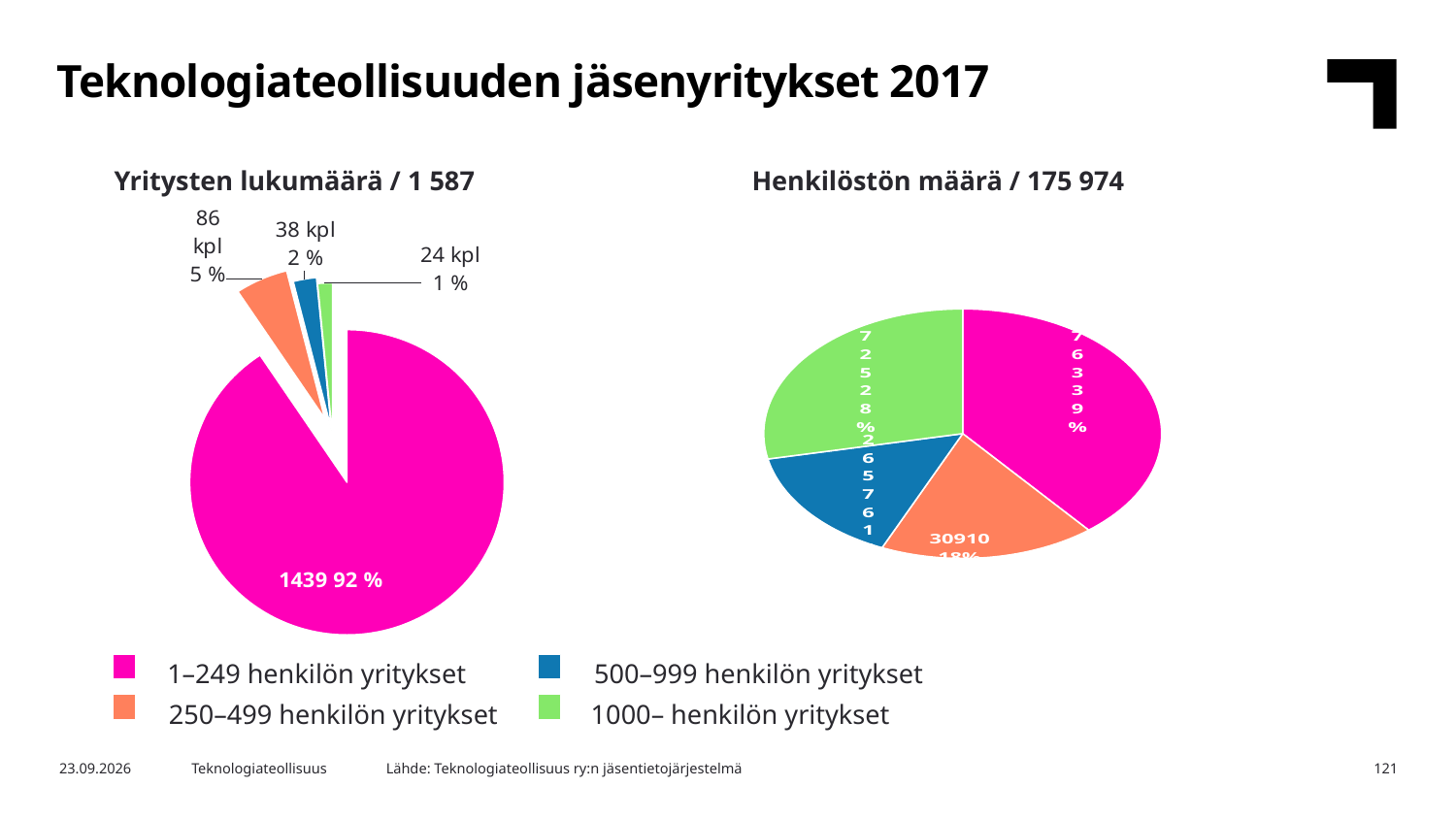
In the left chart "Yritysten lukumäärä / 1 587", what share of the pie do the 1000– henkilön yritykset make up? 1 % In the left chart "Yritysten lukumäärä / 1 587", how many companies are in the 250–499 henkilön yritykset category? 86 kpl What kind of chart is the left chart titled "Yritysten lukumäärä / 1 587"? pie chart In the left chart "Yritysten lukumäärä / 1 587", which category has the smallest slice? 1000– henkilön yritykset How many slices does the right chart "Henkilöstön määrä / 175 974" have? 4 In the left chart "Yritysten lukumäärä / 1 587", which is larger: the 500–999 henkilön yritykset slice or the 1000– henkilön yritykset slice? 500–999 henkilön yritykset In the left chart "Yritysten lukumäärä / 1 587", how many companies are in the 1–249 henkilön yritykset category? 1439 In the left chart "Yritysten lukumäärä / 1 587", what share of the pie do the 1–249 henkilön yritykset make up? 92 % In the right chart "Henkilöstön määrä / 175 974", which category has the largest slice? 1–249 henkilön yritykset How many categories does the shared legend below the charts list? 4 In the left chart "Yritysten lukumäärä / 1 587", what is the difference in number of companies between the 250–499 and 500–999 henkilön yritykset categories? 48 In the right chart "Henkilöstön määrä / 175 974", how many employees are in the 250–499 henkilön yritykset category? 30910